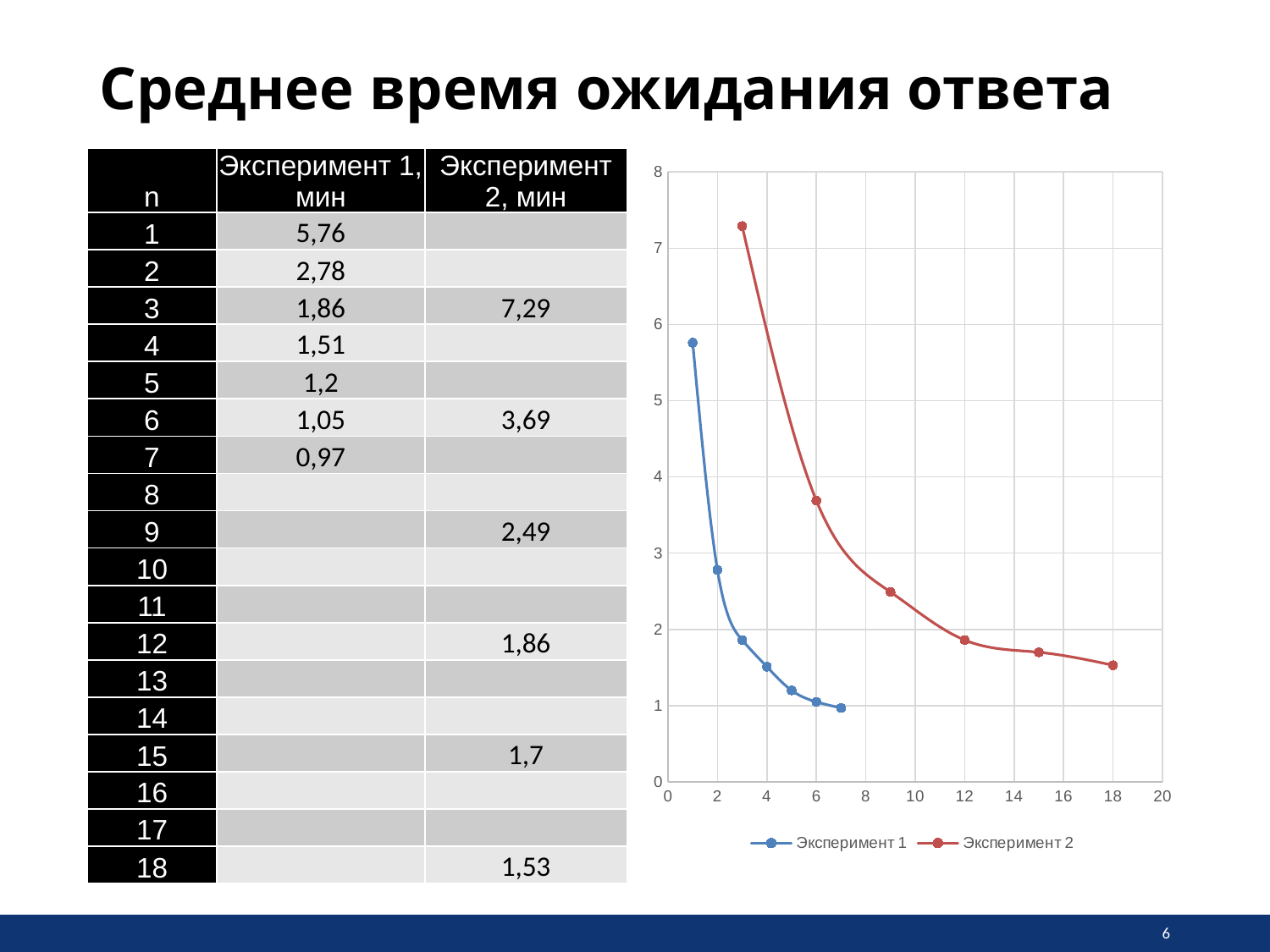
What is the difference between Эксперимент 2 and Эксперимент 1 at n = 6? 2,64 What is the value of Эксперимент 1 at n = 1? 5,76 What is the value of Эксперимент 2 at n = 18? 1,53 At which n does Эксперимент 1 reach its lowest value? 7 How many series does the chart legend list? 2 At which n does Эксперимент 2 reach its highest value? 3 What kind of chart is shown on the slide? line chart At n = 6, which series has the larger value, Эксперимент 1 or Эксперимент 2? Эксперимент 2 Do the values of Эксперимент 1 rise or fall as n increases? fall How many data points are plotted for Эксперимент 1? 7 Is the value of Эксперимент 2 at n = 12 greater or less than 2? less How many data points are plotted for Эксперимент 2? 6